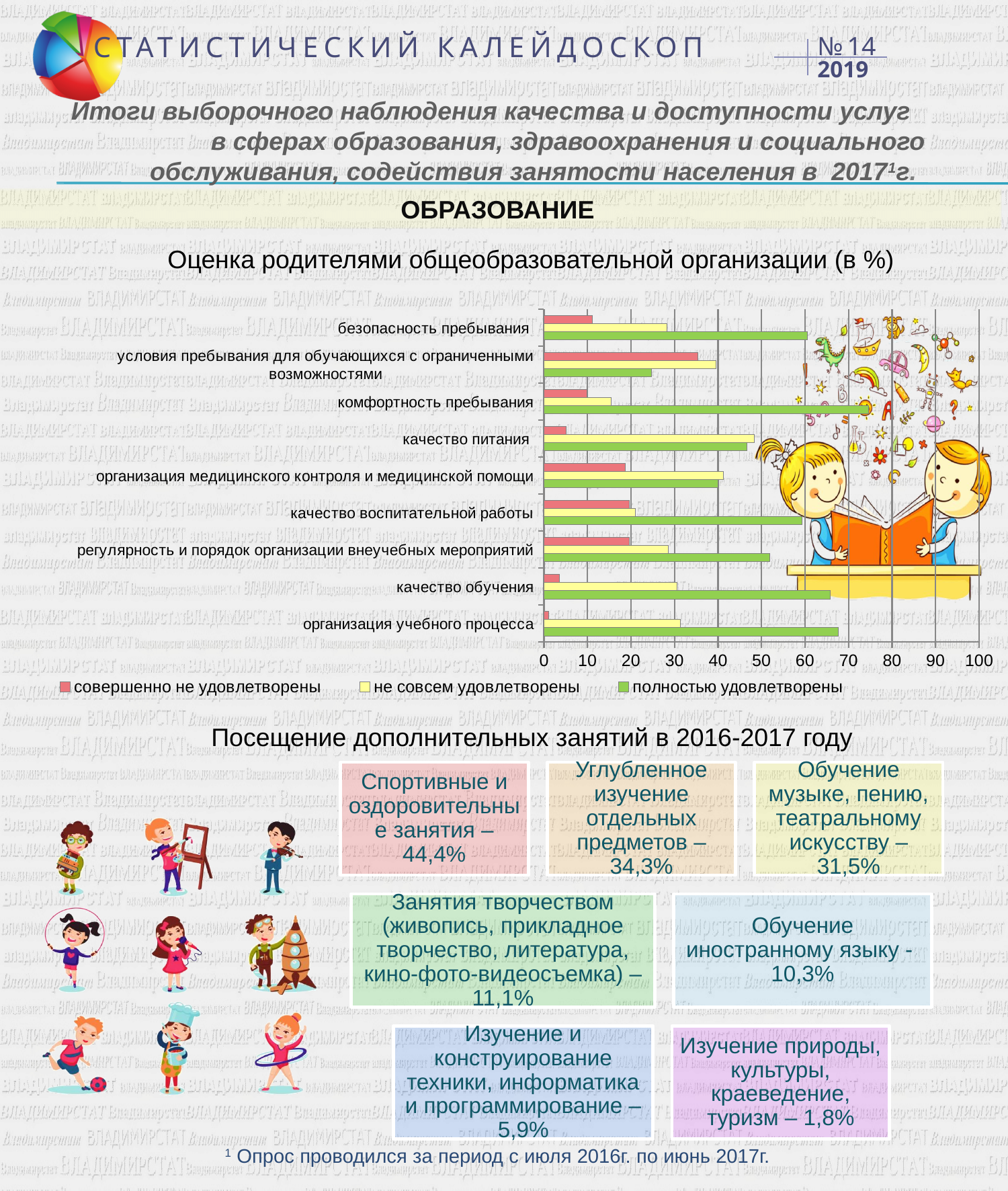
What colour represents 'полностью удовлетворены' in the chart legend? green Is the value for 'полностью удовлетворены' in 'условия пребывания для обучающихся с ограниченными возможностями' greater or less than 30? less For 'безопасность пребывания', which is larger: 'не совсем удовлетворены' or 'полностью удовлетворены'? полностью удовлетворены Which category has the highest value for 'совершенно не удовлетворены'? условия пребывания для обучающихся с ограниченными возможностями Is the value for 'полностью удовлетворены' in 'комфортность пребывания' greater or less than 60? greater What kind of chart is used for 'Оценка родителями общеобразовательной организации (в %)'? bar chart Which category has the lowest value for 'совершенно не удовлетворены'? организация учебного процесса Which category has the highest value for 'полностью удовлетворены'? комфортность пребывания How many series does the legend of the chart list? 3 Is the value for 'не совсем удовлетворены' in 'качество обучения' greater or less than 40? less How many categories are shown on the chart's vertical axis? 9